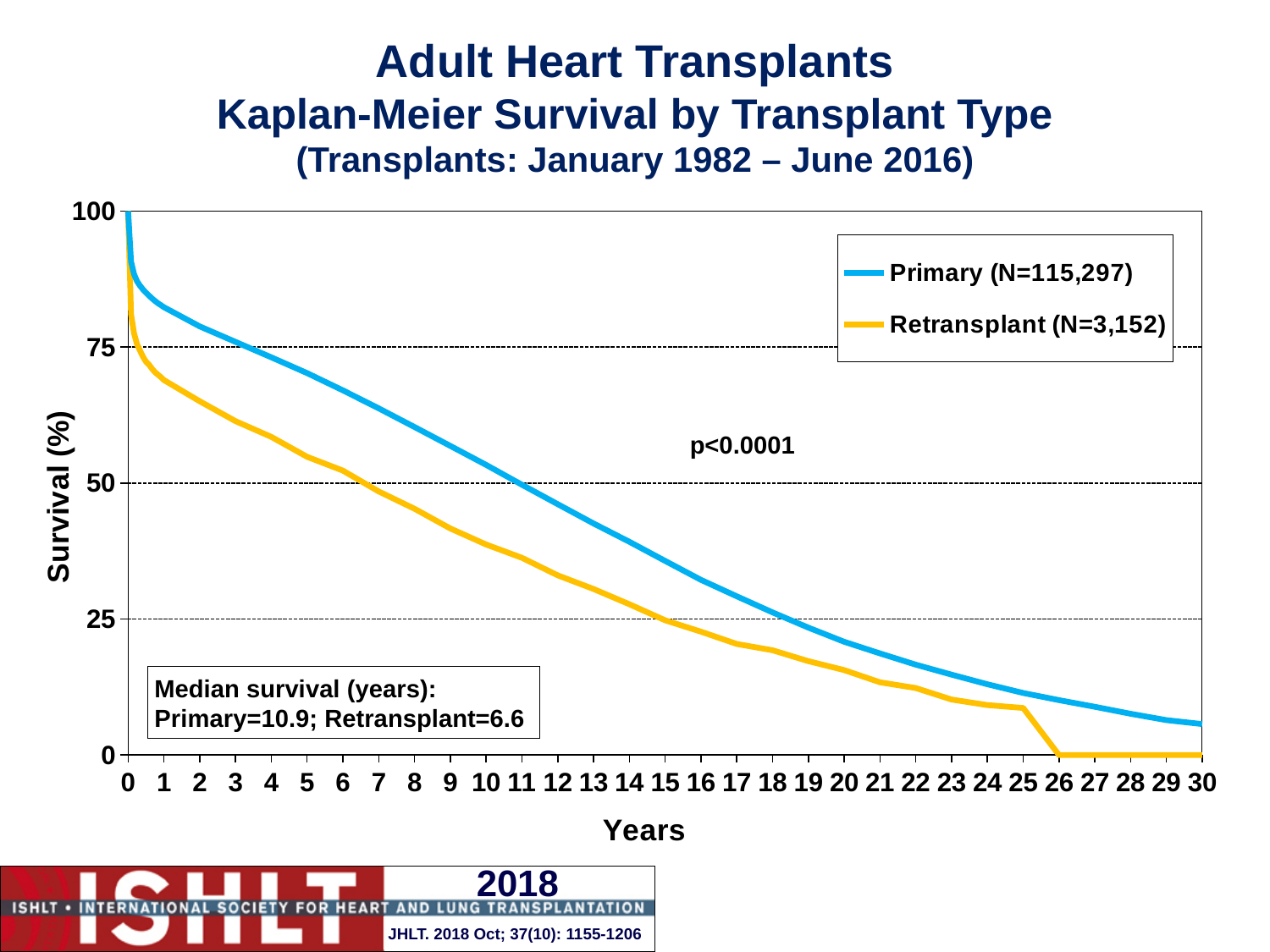
What is the N for the Primary series shown in the legend? 115,297 What is the label of the y axis? Survival (%) What is the median survival in years for Primary transplants? 10.9 What is the N for the Retransplant series shown in the legend? 3,152 Is the survival for Retransplant at 20 years greater or less than 25? less Do the survival curves rise or fall as years increase? fall What is the median survival in years for Retransplant? 6.6 How many series does the legend list? 2 Is the survival for Primary at 5 years greater or less than 50? greater At 10 years, which series has the higher survival, Primary or Retransplant? Primary What kind of chart is shown on the slide? line chart What p-value is printed on the chart? p<0.0001